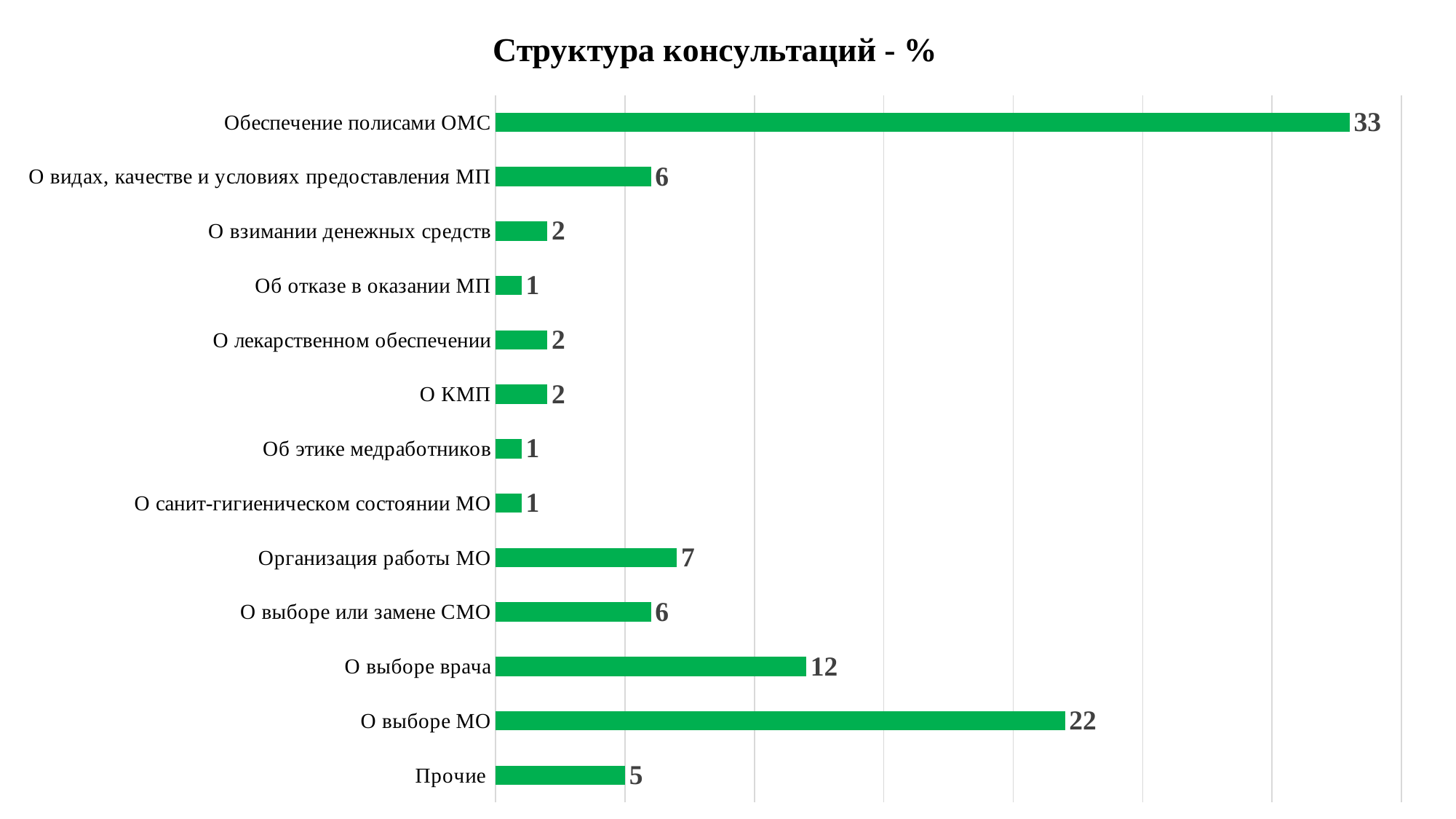
What is the difference between the values for О выборе врача and О выборе или замене СМО? 6 Which category has the highest value? Обеспечение полисами ОМС Which is larger, the value for Организация работы МО or the value for О взимании денежных средств? Организация работы МО What is the value for О выборе врача? 12 What is the title of the chart? Структура консультаций - % What is the difference between the values for Обеспечение полисами ОМС and О выборе МО? 11 What kind of chart is shown on the slide? Bar chart What is the value for Обеспечение полисами ОМС? 33 What is the value for Прочие? 5 Which is larger, the value for О выборе МО or the value for О выборе врача? О выборе МО What is the value for Организация работы МО? 7 How many categories are shown in the chart? 13